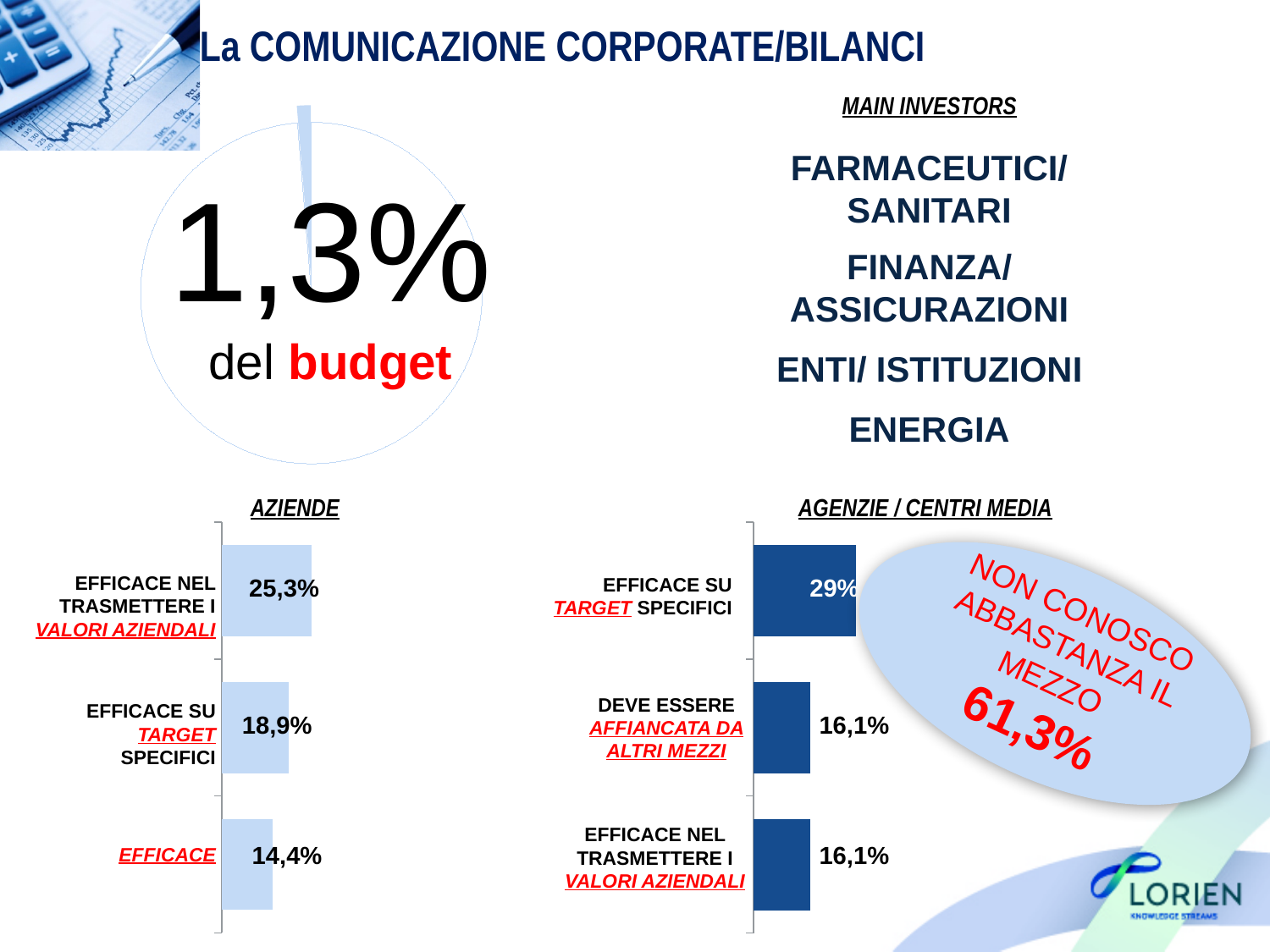
In the AGENZIE / CENTRI MEDIA chart, what is the value for DEVE ESSERE AFFIANCATA DA ALTRI MEZZI? 16,1% In the AGENZIE / CENTRI MEDIA chart, which category has the highest value? EFFICACE SU TARGET SPECIFICI In the AGENZIE / CENTRI MEDIA chart, what is the value for EFFICACE SU TARGET SPECIFICI? 29% Which is larger: the value for EFFICACE SU TARGET SPECIFICI in the AZIENDE chart or in the AGENZIE / CENTRI MEDIA chart? AGENZIE / CENTRI MEDIA In the AZIENDE chart, which category has the highest value? EFFICACE NEL TRASMETTERE I VALORI AZIENDALI In the AZIENDE chart, what is the value for EFFICACE SU TARGET SPECIFICI? 18,9% In the AZIENDE chart, what is the value for EFFICACE? 14,4% In the AZIENDE chart, what is the value for EFFICACE NEL TRASMETTERE I VALORI AZIENDALI? 25,3% In the AZIENDE chart, which category has the lowest value? EFFICACE How many bars are shown in the AGENZIE / CENTRI MEDIA chart? 3 In the AZIENDE chart, what is the difference between the values for EFFICACE NEL TRASMETTERE I VALORI AZIENDALI and EFFICACE? 10,9% What kind of chart is the AZIENDE chart? Bar chart